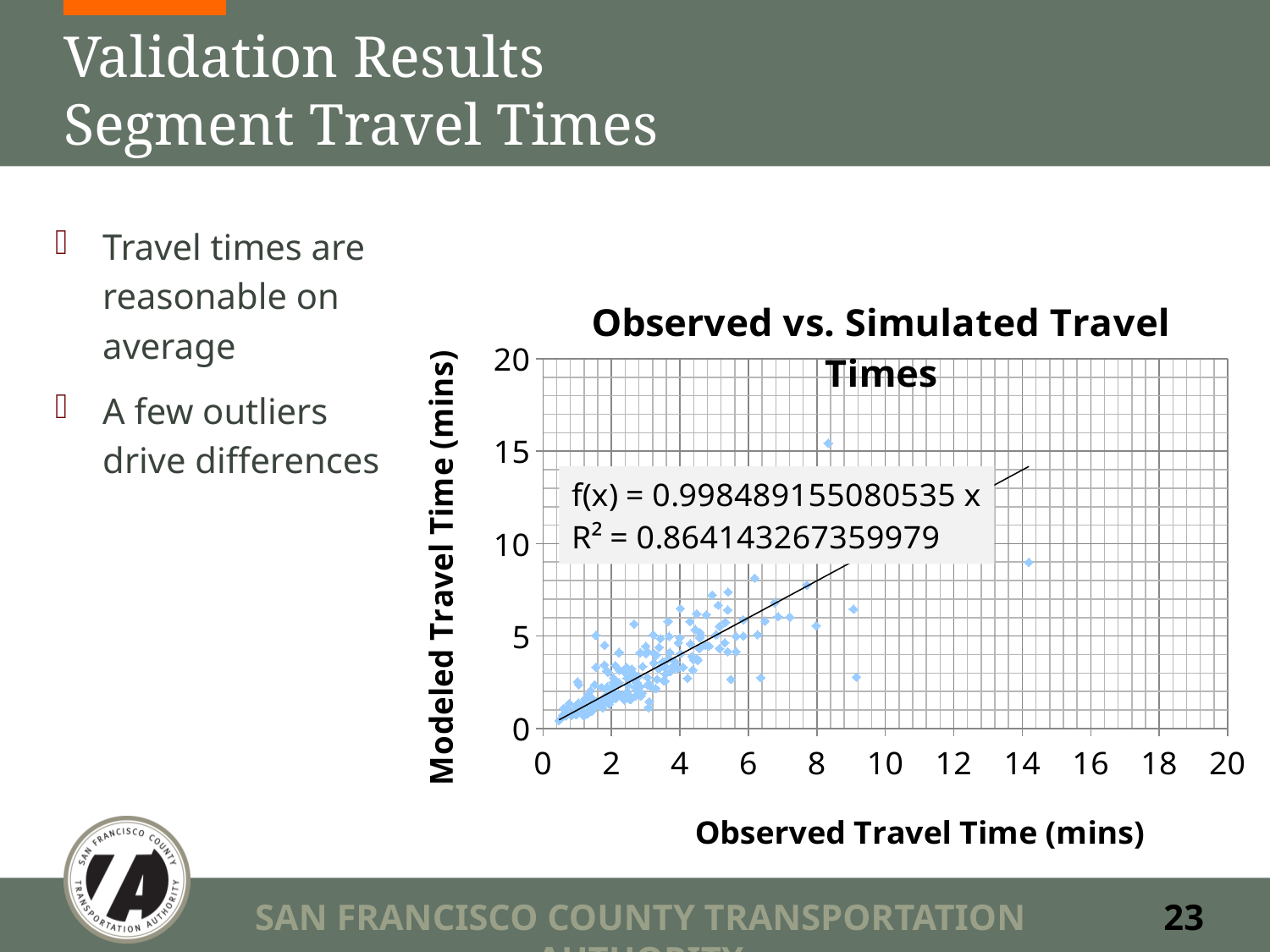
Is the highest modeled travel time plotted on the chart greater or less than 10? greater Do modeled travel times generally rise or fall as observed travel times increase? Rise What kind of chart is shown on the slide? Scatter chart What is the interval between consecutive tick labels on the x axis? 2 Is the R² value shown on the chart greater or less than 0.5? greater What is the maximum value shown on the y axis of the chart? 20 What is the trendline equation shown on the chart? f(x) = 0.998489155080535 x Is the modeled travel time for the point with the largest observed travel time (around 14 mins) greater or less than 10? less What is the label of the x axis of the chart? Observed Travel Time (mins) What R² value is shown on the chart? 0.864143267359979 What is the maximum value shown on the x axis of the chart? 20 What is the title of the chart? Observed vs. Simulated Travel Times